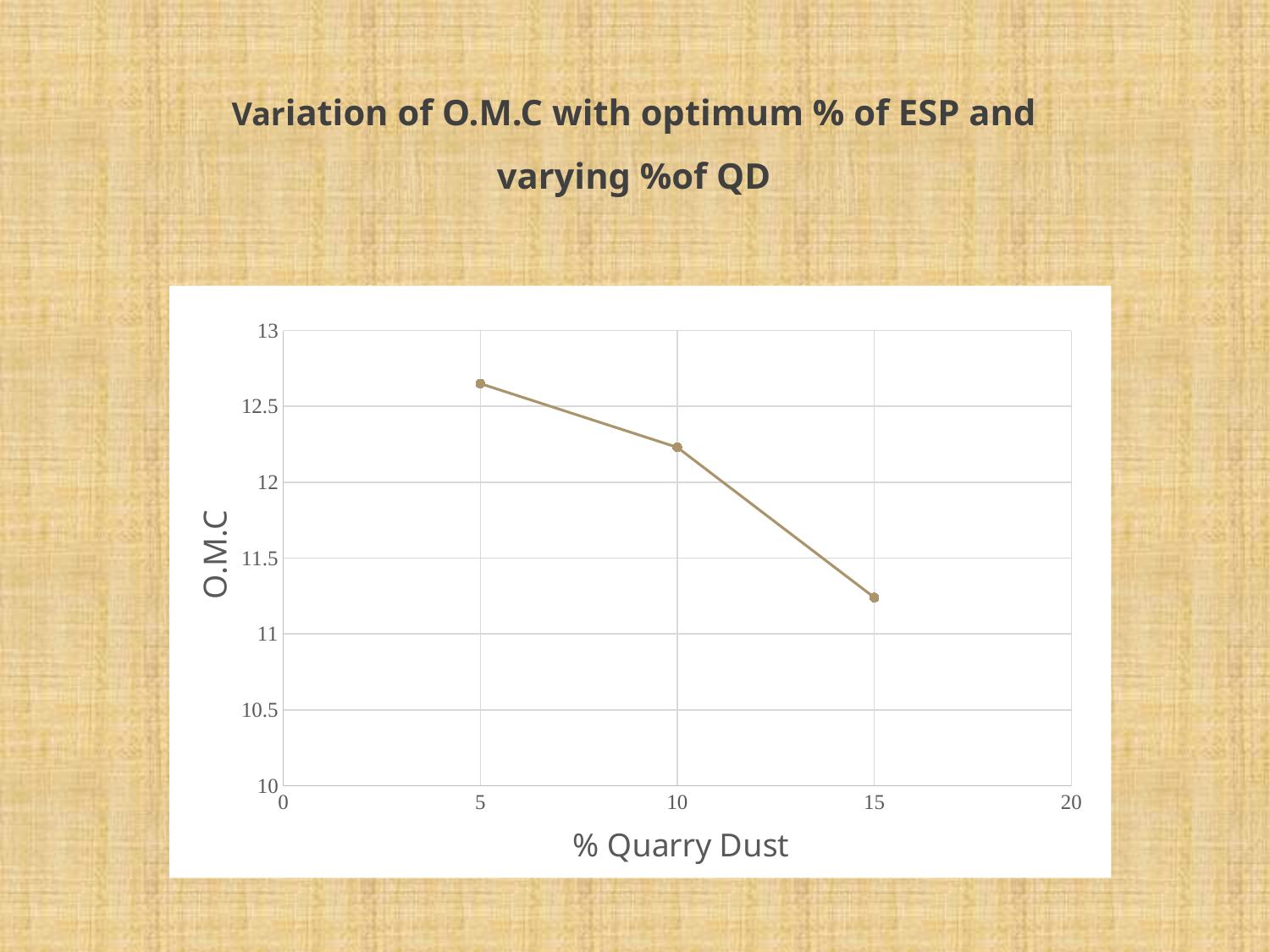
Is the O.M.C value at 10% Quarry Dust greater or less than 12? greater Which has a higher O.M.C value: 10% Quarry Dust or 15% Quarry Dust? 10% Quarry Dust Is the O.M.C value at 15% Quarry Dust greater or less than 11? greater How many data points are plotted on the chart? 3 What kind of chart is shown on the slide? line chart Is the O.M.C value at 15% Quarry Dust greater or less than 11.5? less What is the label on the horizontal axis of the chart? % Quarry Dust At which % Quarry Dust value is O.M.C highest? 5 Do the O.M.C values rise or fall as % Quarry Dust increases? fall What is the label on the vertical axis of the chart? O.M.C At which % Quarry Dust value is O.M.C lowest? 15